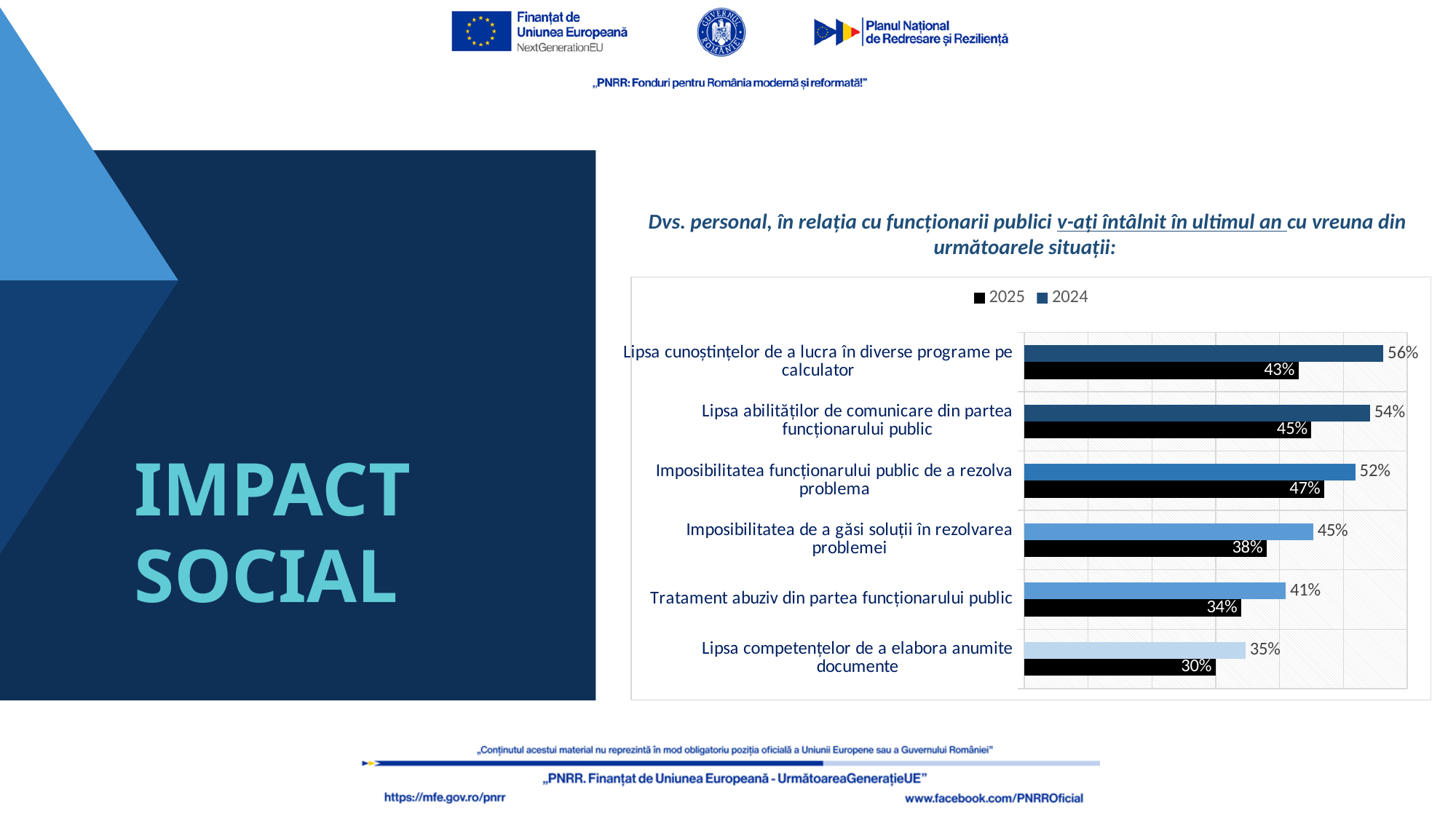
What is the difference between the 2024 and 2025 values for 'Lipsa competențelor de a elabora anumite documente'? 5% What is the difference between the 2024 and 2025 values for 'Lipsa cunoștințelor de a lucra în diverse programe pe calculator'? 13% Which category has the lowest 2025 value? Lipsa competențelor de a elabora anumite documente How many categories are shown in the chart? 6 How many series does the chart legend list? 2 Which category has the highest 2024 value? Lipsa cunoștințelor de a lucra în diverse programe pe calculator What type of chart is shown on the slide? bar chart Which is larger for 'Imposibilitatea de a găsi soluții în rezolvarea problemei': the 2024 value or the 2025 value? 2024 What is the 2025 value for 'Tratament abuziv din partea funcționarului public'? 34% What is the 2025 value for 'Imposibilitatea funcționarului public de a rezolva problema'? 47% Which series is shown in black in the chart? 2025 What is the 2024 value for 'Lipsa cunoștințelor de a lucra în diverse programe pe calculator'? 56%